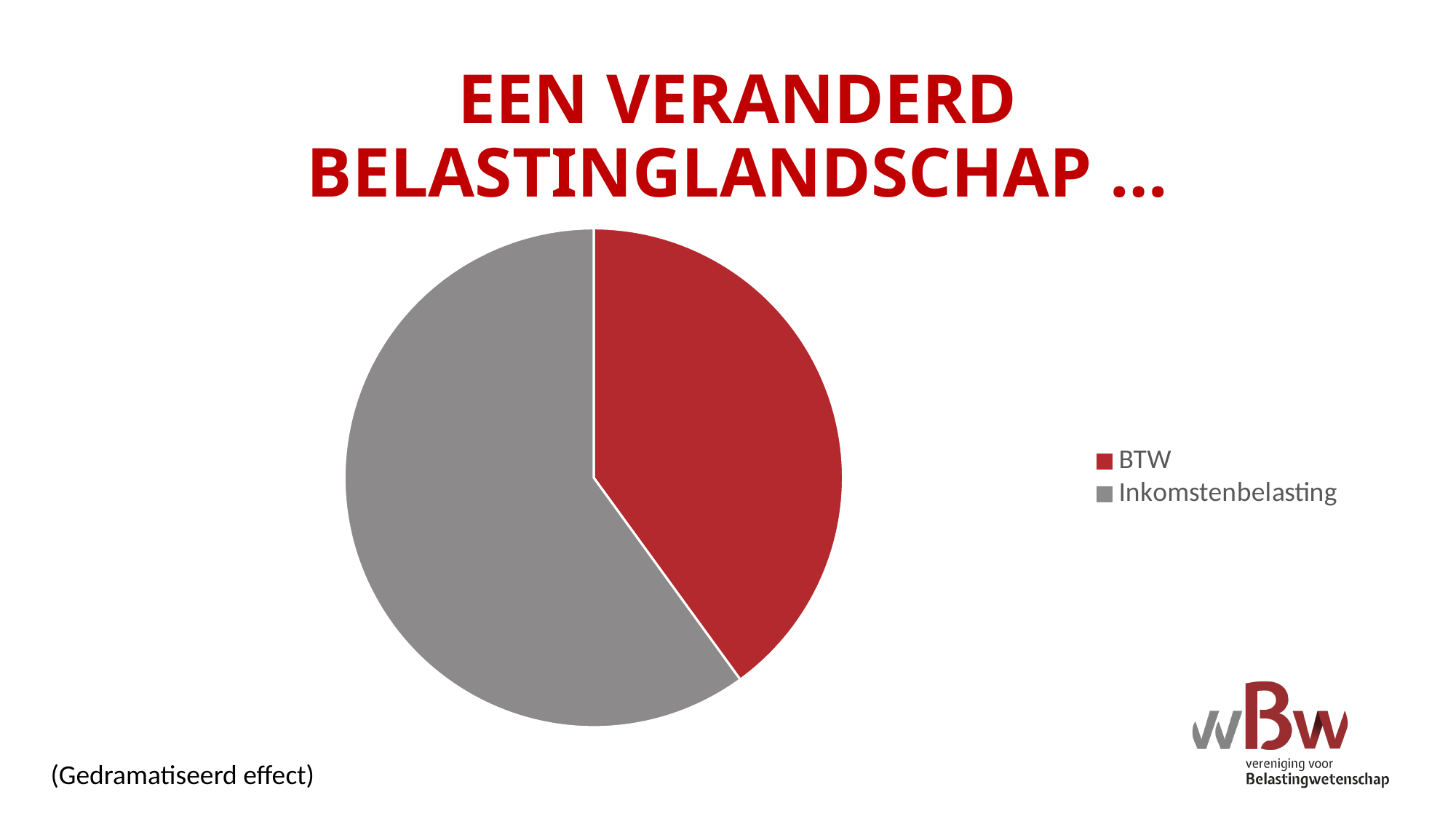
How many entries does the legend of the pie chart list? 2 What colour is the BTW slice in the pie chart? red What colour is the Inkomstenbelasting slice in the pie chart? grey How many slices does the pie chart have? 2 Which slice of the pie chart is the smallest? BTW Does the Inkomstenbelasting slice take up more or less than half of the pie chart? more Which is larger in the pie chart, BTW or Inkomstenbelasting? Inkomstenbelasting What kind of chart is shown on the slide? pie chart Does the BTW slice take up more or less than half of the pie chart? less Which slice of the pie chart is the largest? Inkomstenbelasting